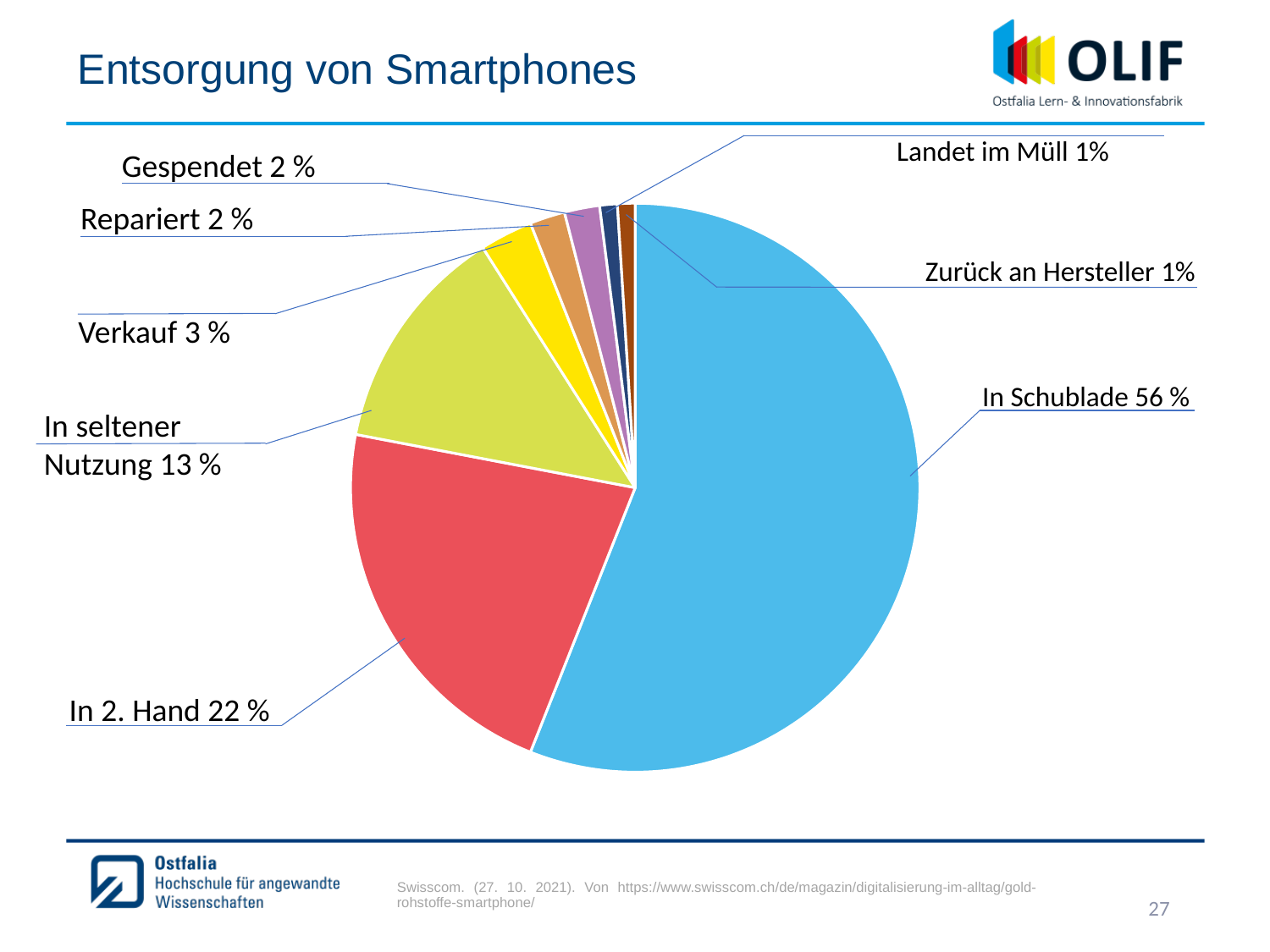
What is the title of the slide containing the pie chart? Entsorgung von Smartphones What is the difference in percentage points between 'Verkauf' and 'Repariert'? 1 How many slices does the pie chart have? 8 What percentage is shown for 'In seltener Nutzung'? 13 % Which is larger, the slice for 'In seltener Nutzung' or the slice for 'Verkauf'? In seltener Nutzung What percentage is shown for 'Verkauf'? 3 % What share of smartphones ends up 'In Schublade'? 56 % What percentage is shown for 'In 2. Hand'? 22 % What percentage is shown for 'Landet im Müll'? 1% What is the difference in percentage points between 'In Schublade' and 'In 2. Hand'? 34 Which category has the largest slice of the pie? In Schublade What kind of chart is shown on the slide? pie chart